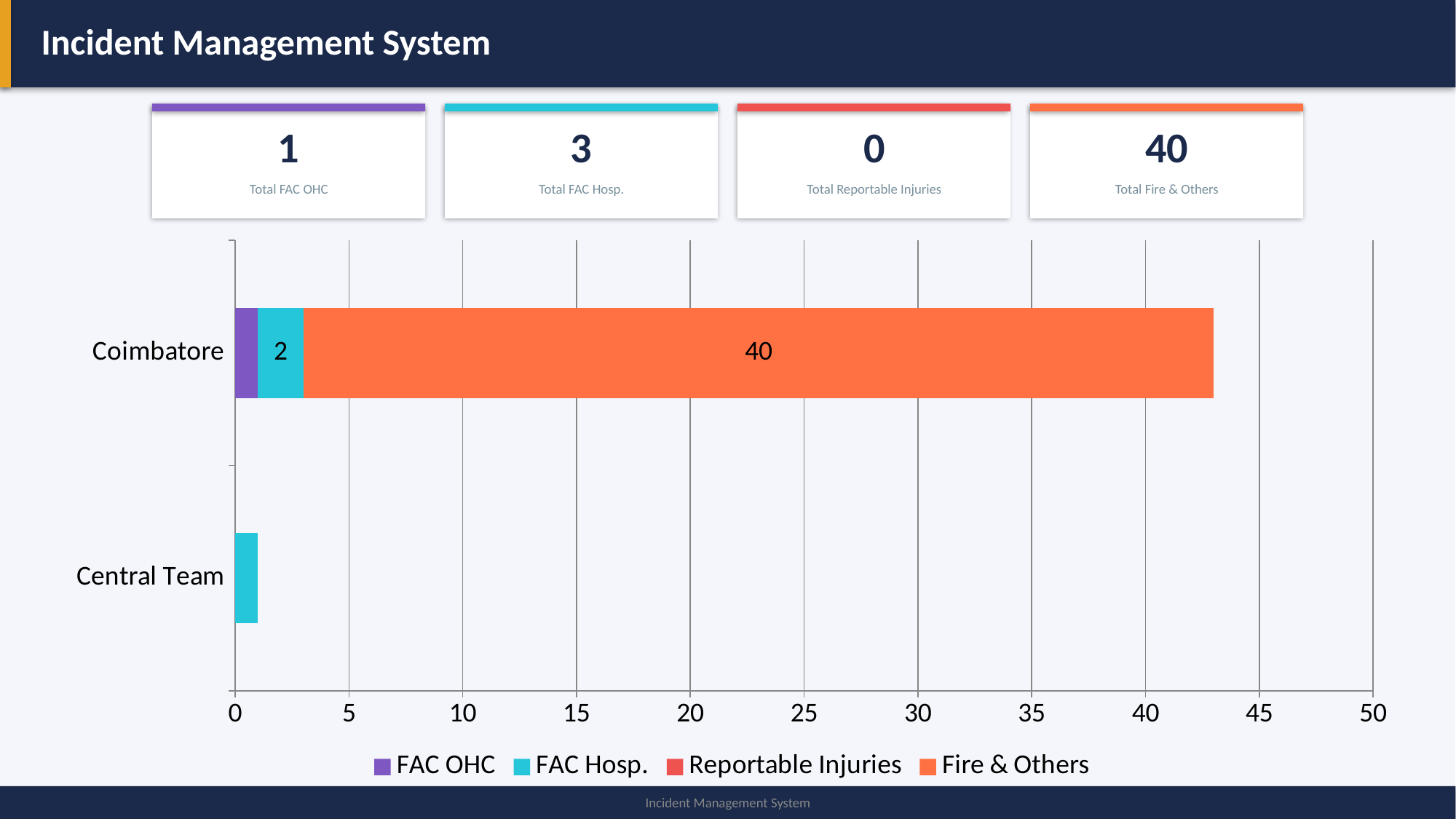
Which category has the shorter total bar? Central Team Is the total bar length for Central Team greater or less than 5? less What is the Fire & Others value for Coimbatore? 40 Which series is shown in orange in the legend? Fire & Others What is the highest value shown on the horizontal axis? 50 Is the total bar length for Coimbatore greater or less than 40? greater What kind of chart is shown on the slide? Stacked bar chart How many categories are shown on the vertical axis? 2 What is the difference between the Fire & Others value and the FAC Hosp. value for Coimbatore? 38 Which category has the longer total bar, Coimbatore or Central Team? Coimbatore How many series does the legend list? 4 What is the FAC Hosp. value for Coimbatore? 2